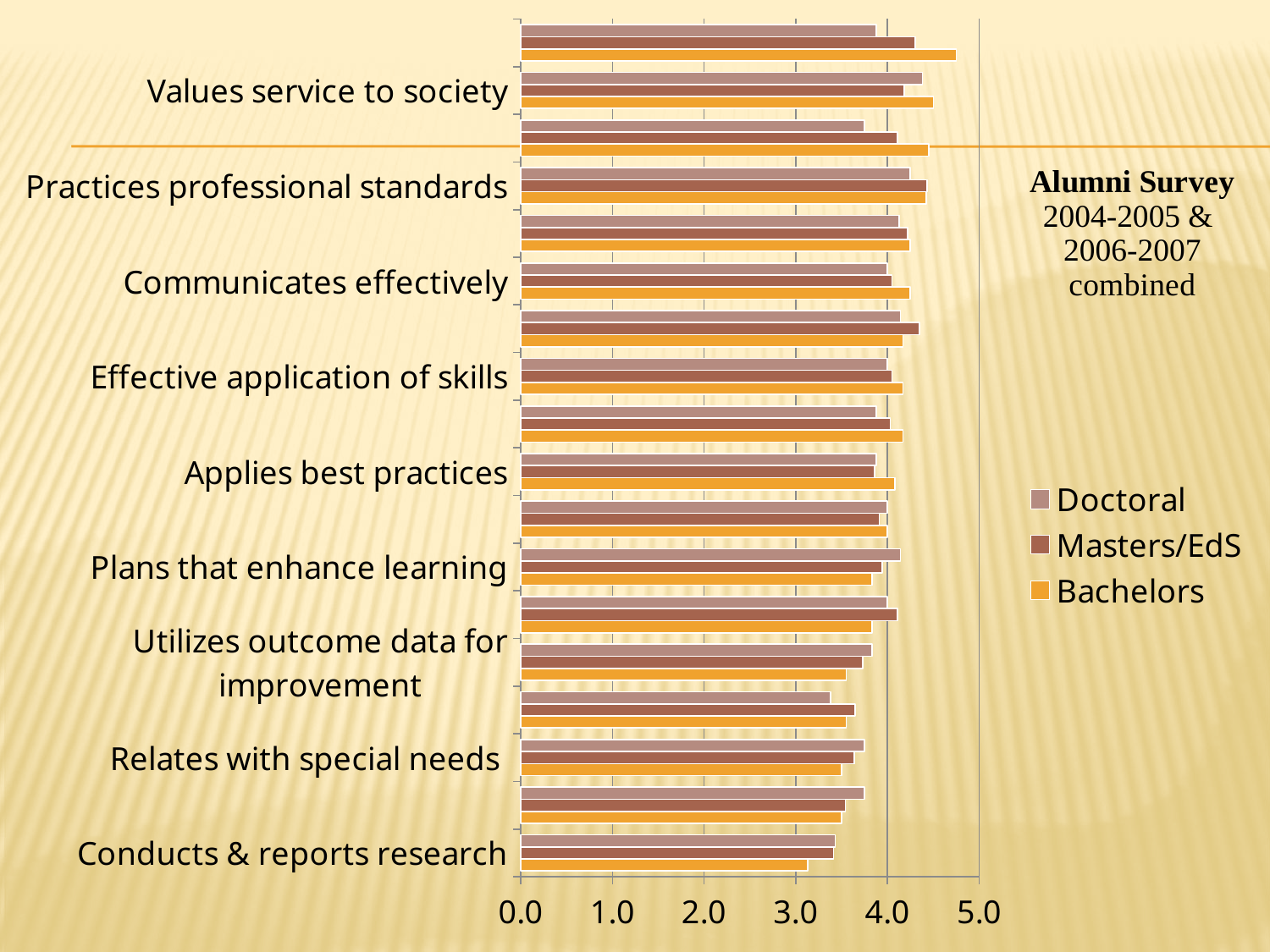
Is the Masters/EdS value for Practices professional standards greater or less than 4.0? greater Which category has the lowest Bachelors value? Conducts & reports research What are the three series listed in the legend? Doctoral, Masters/EdS, Bachelors What survey does the text on the slide say the chart data comes from? Alumni Survey 2004-2005 & 2006-2007 combined How many series does the legend list? 3 Is the Bachelors value for Utilizes outcome data for improvement greater or less than 4.0? less Is the Bachelors value for Conducts & reports research greater or less than 4.0? less What kind of chart is shown on the slide? bar chart Which is larger: the Bachelors value for Values service to society or the Bachelors value for Conducts & reports research? Values service to society